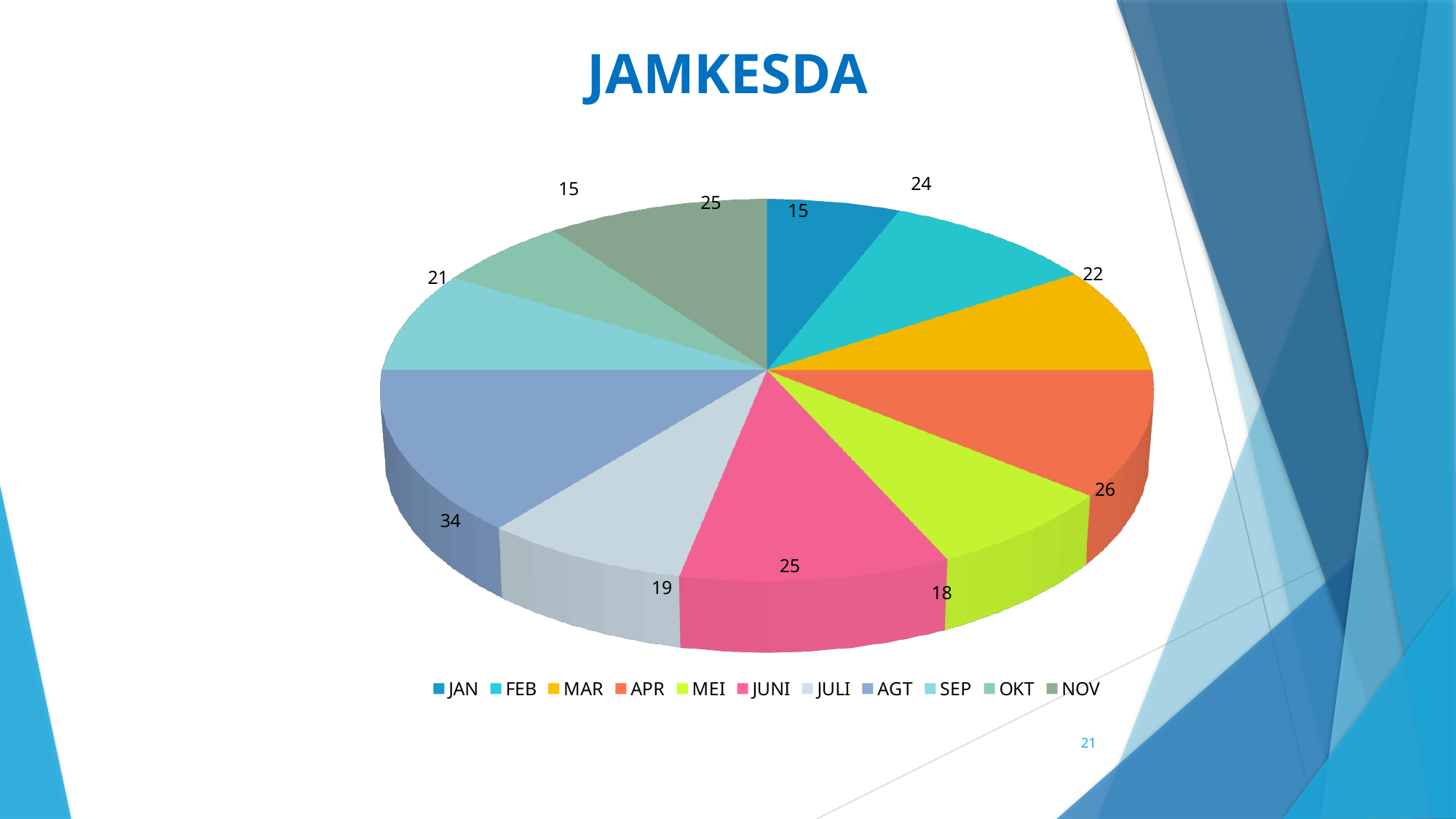
What is the title of the chart? JAMKESDA What is the smallest value shown on the chart? 15 What is the value for SEP? 21 Which is larger, the value for FEB or the value for MAR? FEB What is the value for JULI? 19 What is the value for APR? 26 What is the value for AGT? 34 What is the difference between the values for AGT and MEI? 16 Which month has the largest slice? AGT What type of chart is shown on the slide? pie chart What is the difference between the values for JUNI and JAN? 10 How many months are shown in the chart? 11